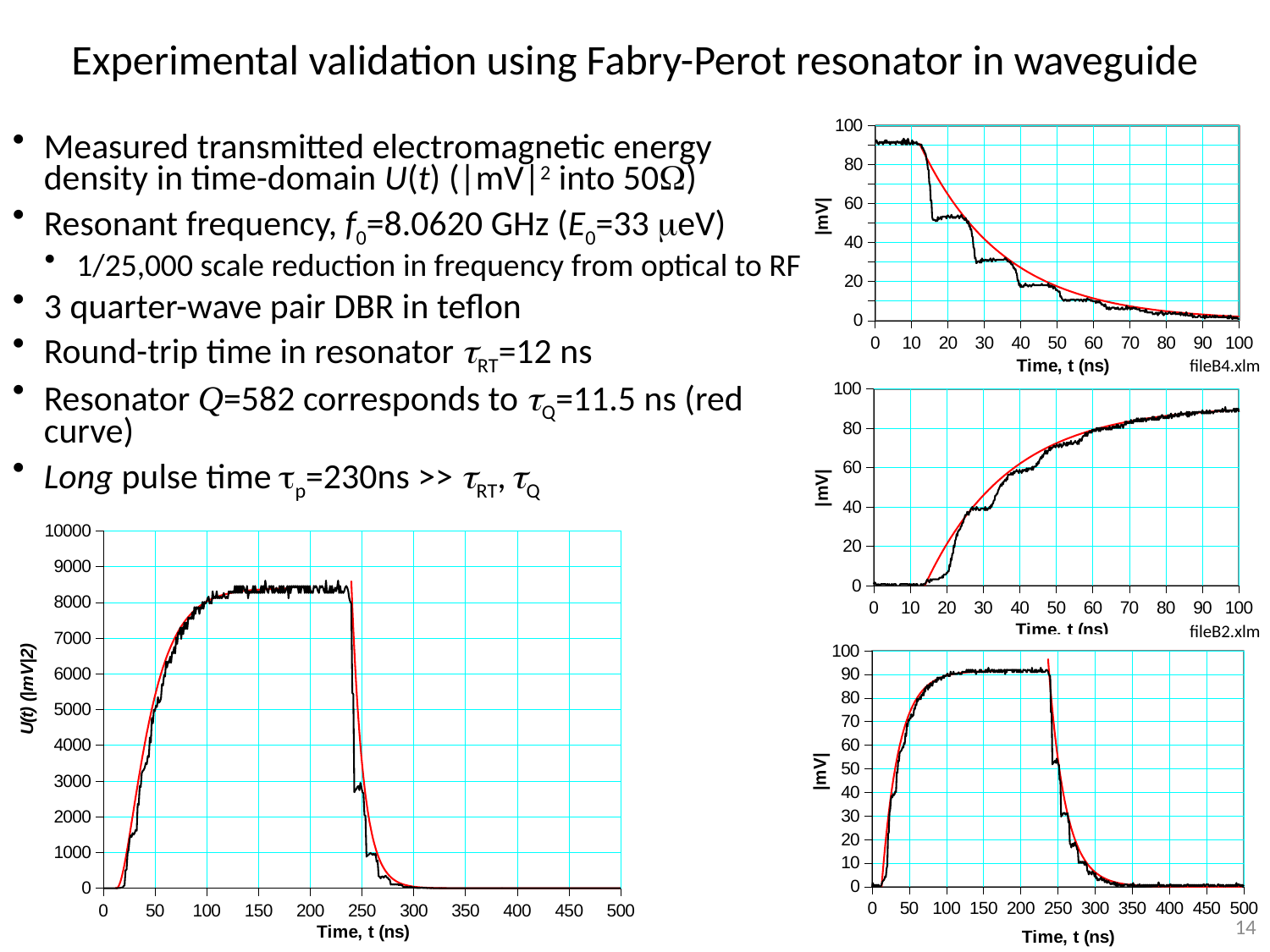
In the top-right chart (fileB4.xlm), is the value at t = 60 ns greater or less than 40 mV? less In the middle-right chart (fileB2.xlm), is the value at t = 90 ns greater or less than 60 mV? greater In the bottom-left chart, is the value of U(t) at t = 150 ns greater or less than 5000? greater In the top-right chart (fileB4.xlm), do the values rise or fall as time increases from 10 ns to 100 ns? fall What is the x-axis label of the bottom-left chart? Time, t (ns) In the middle-right chart (fileB2.xlm), do the values rise or fall as time increases from 10 ns to 100 ns? rise In the bottom-left chart, which is larger: the value of U(t) at t = 100 ns or at t = 300 ns? t = 100 ns What kind of chart is the large chart at the bottom left of the slide? line chart